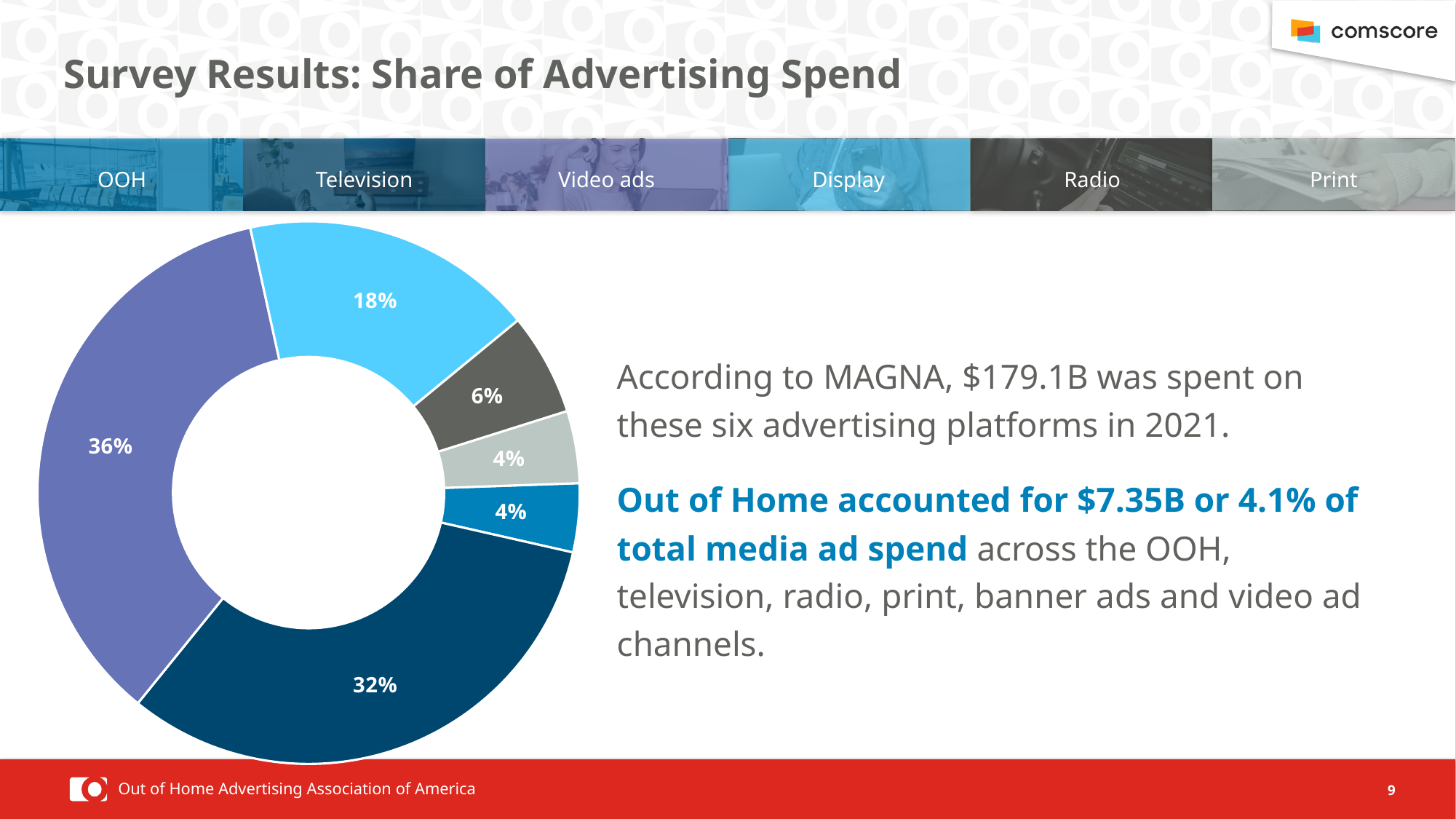
What share of advertising spend does the OOH slice show in the pie chart? 4% Which has a larger share of advertising spend, Display or Radio? Display What share of advertising spend does the Video ads slice show in the pie chart? 36% What share of advertising spend does the Display slice show in the pie chart? 18% What share of advertising spend does the Print slice show in the pie chart? 4% By how many percentage points does the Video ads share exceed the Television share? 4 percentage points What share of advertising spend does the Radio slice show in the pie chart? 6% What share of advertising spend does the Television slice show in the pie chart? 32% What kind of chart is shown on the slide? Pie chart (donut) How many slices does the pie chart have? 6 Which advertising platform has the largest slice in the pie chart? Video ads What is the title of the slide containing the chart? Survey Results: Share of Advertising Spend